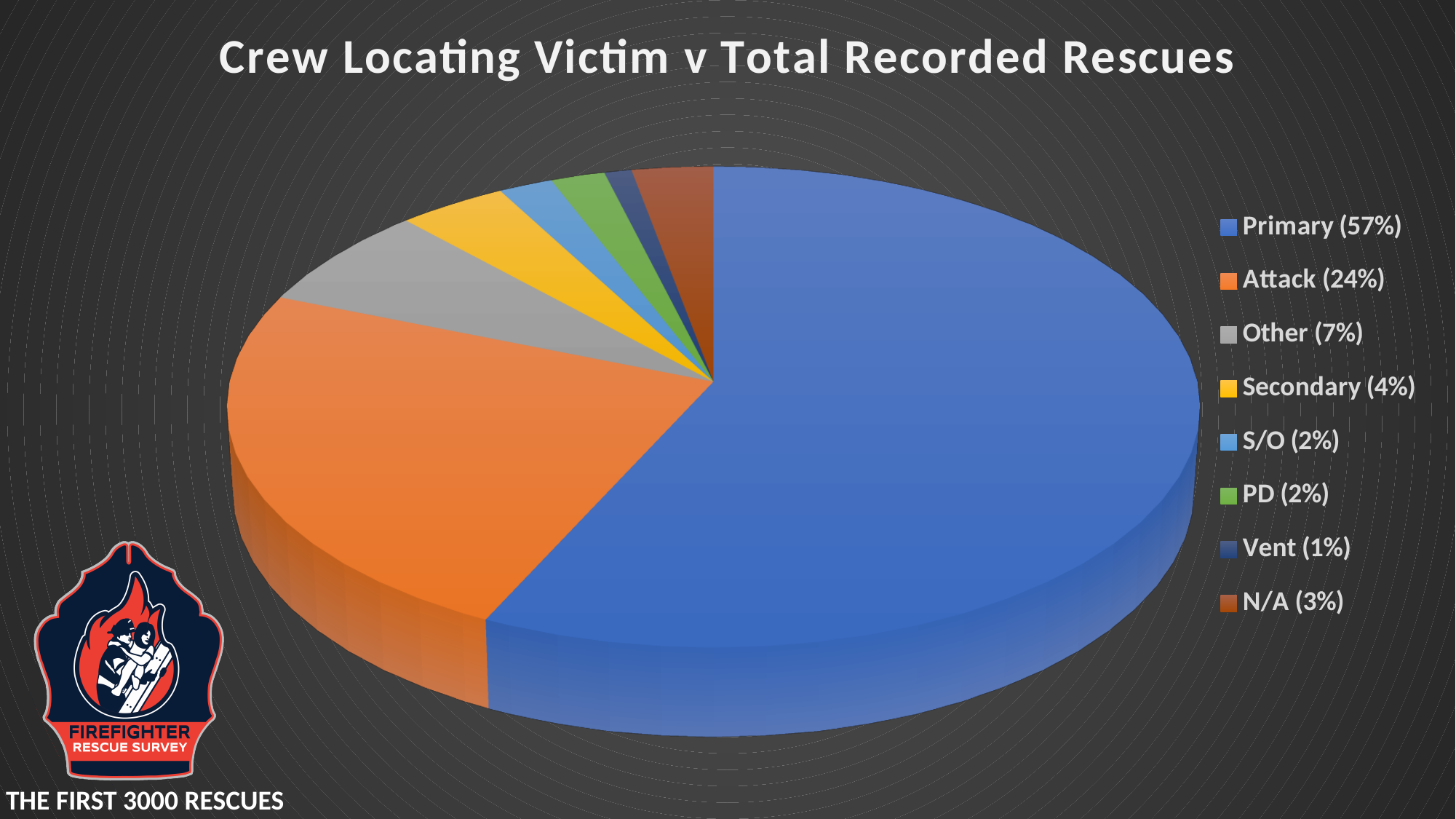
What is the difference in percentage points between Primary and Attack? 33 What percentage is shown for Other? 7% Which category has the smallest share of the pie? Vent What share of the pie does the Primary slice represent? 57% What is the title of the chart? Crew Locating Victim v Total Recorded Rescues Which is larger, the share for Other or the share for N/A? Other What percentage is shown for Attack? 24% What percentage is shown for Secondary? 4% Which category has the largest share of the pie? Primary What kind of chart is shown on the slide? Pie chart What colour is the Secondary slice? Yellow How many categories does the legend list? 8